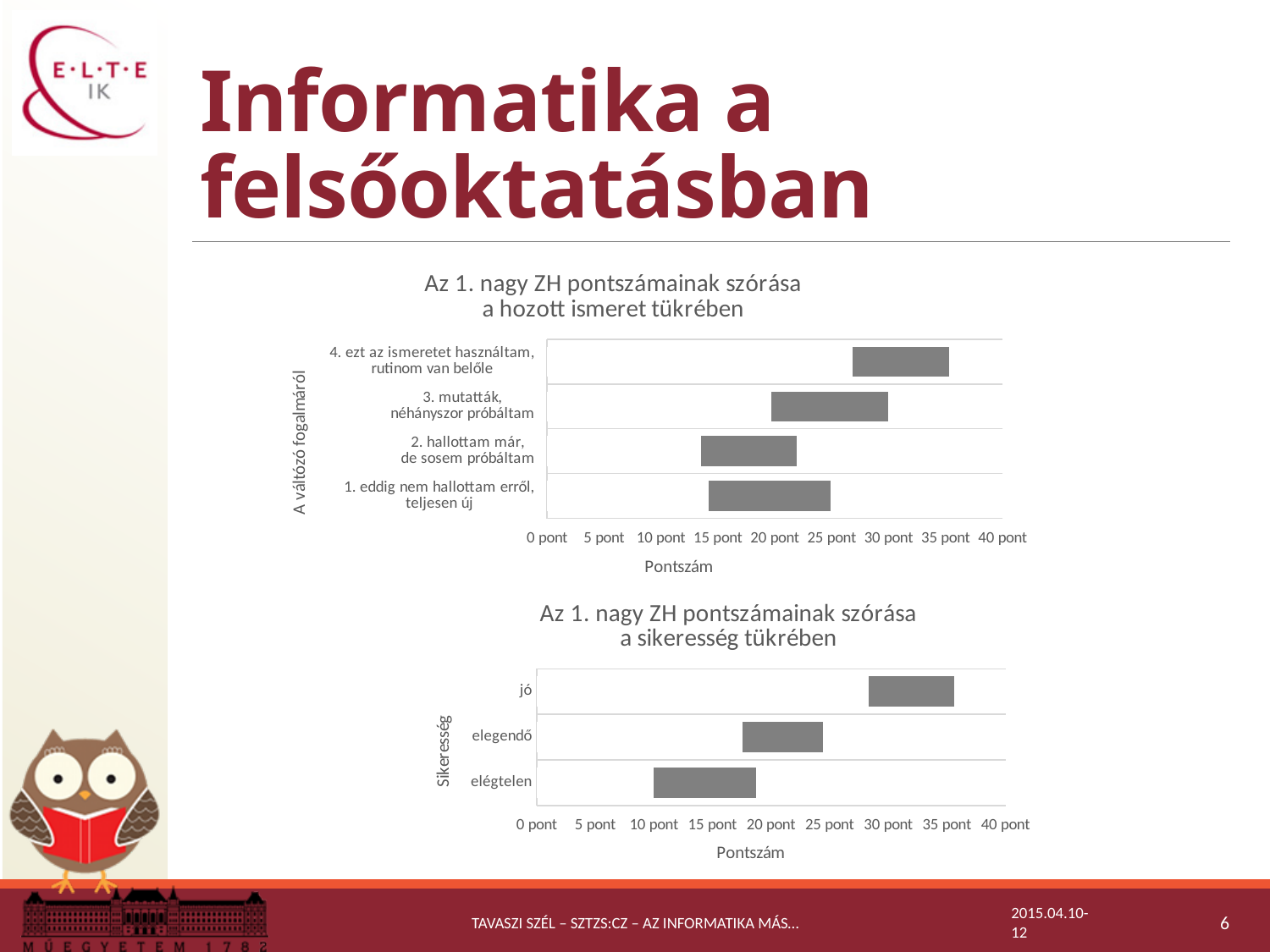
What is the y-axis title of the top chart ('a hozott ismeret tükrében')? A változó fogalmáról What kind of chart is the top chart, 'Az 1. nagy ZH pontszámainak szórása a hozott ismeret tükrében'? bar chart In the bottom chart ('a sikeresség tükrében'), is the upper end of the bar for 'jó' greater or less than 30 pont? greater How many categories are shown on the y axis of the top chart ('a hozott ismeret tükrében')? 4 What is the x-axis title of the bottom chart ('a sikeresség tükrében')? Pontszám In the bottom chart ('a sikeresség tükrében'), which category's bar starts at the lowest point score? elégtelen In the top chart ('a hozott ismeret tükrében'), is the lower end of the bar for '4. ezt az ismeretet használtam, rutinom van belőle' greater or less than 25 pont? greater In the top chart ('a hozott ismeret tükrében'), which category's bar reaches the highest point score? 4. ezt az ismeretet használtam, rutinom van belőle In the top chart ('a hozott ismeret tükrében'), which bar reaches a higher point score: '3. mutatták, néhányszor próbáltam' or '2. hallottam már, de sosem próbáltam'? 3. mutatták, néhányszor próbáltam In the bottom chart ('a sikeresség tükrében'), which category's bar reaches the highest point score? jó In the bottom chart ('a sikeresség tükrében'), is the upper end of the bar for 'elégtelen' greater or less than 20 pont? less How many categories are shown on the y axis of the bottom chart ('a sikeresség tükrében')? 3